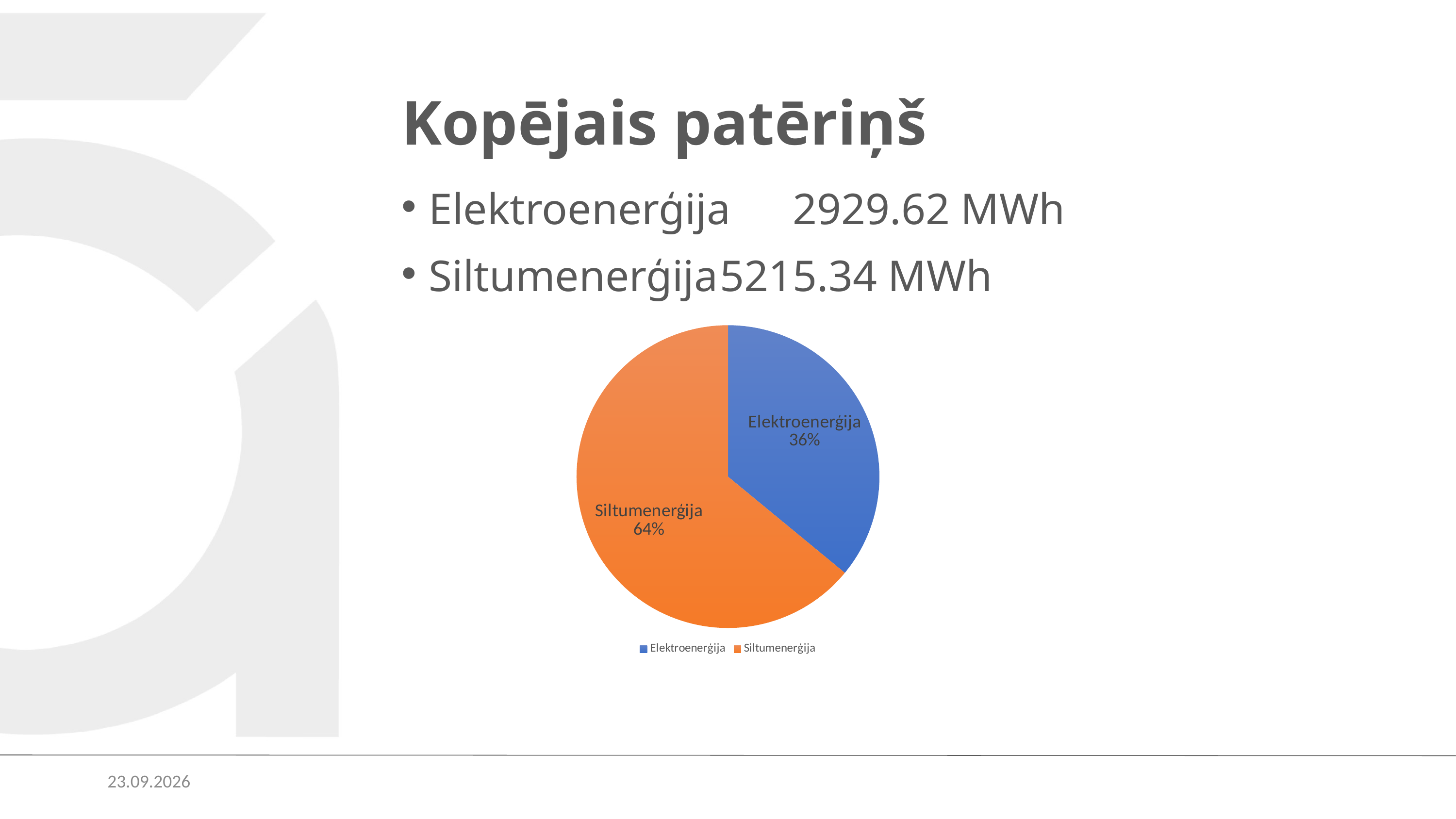
What colour is the Siltumenerģija slice? orange What kind of chart is shown on the slide? pie chart How many slices does the pie chart have? 2 Which slice of the pie chart is the smallest? Elektroenerģija How many entries does the legend list? 2 What colour is the Elektroenerģija slice? blue What share of the pie does Siltumenerģija represent? 64% Which is larger in the pie chart, Elektroenerģija or Siltumenerģija? Siltumenerģija What is the difference in percentage points between the Siltumenerģija and Elektroenerģija slices? 28 Which slice of the pie chart is the largest? Siltumenerģija What share of the pie does Elektroenerģija represent? 36%